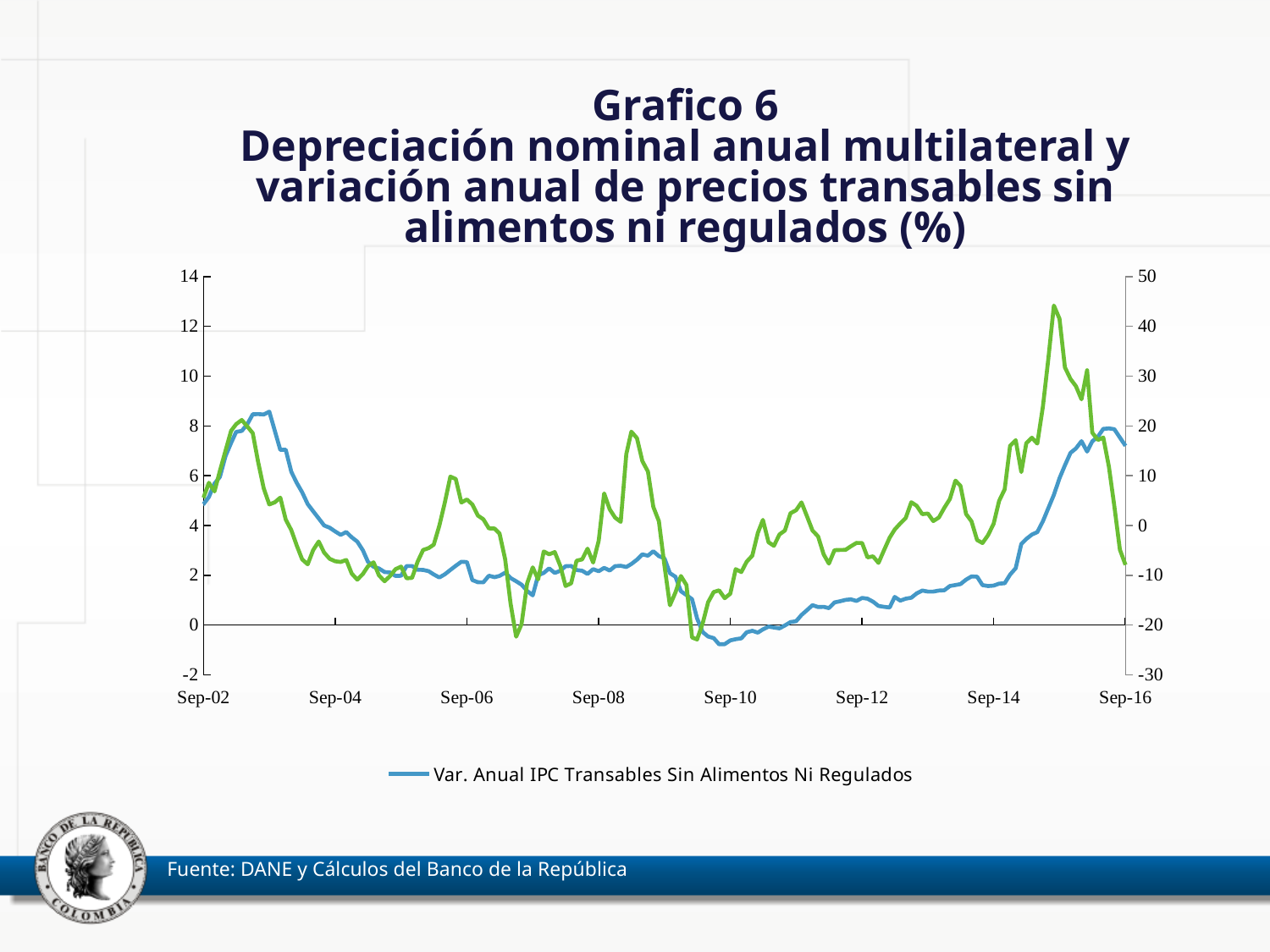
What is the number of the graph given in the title? Grafico 6 Does the blue line (Var. Anual IPC Transables) rise or fall between Sep-12 and Sep-16? rise Is the value of the blue line (Var. Anual IPC Transables) at Sep-02 greater or less than 4 on the left axis? greater How many series does the legend list? 1 Is the peak of the green line, reached between Sep-14 and Sep-16, greater or less than 40 on the right axis? greater Does the blue line (Var. Anual IPC Transables) rise or fall between Sep-04 and Sep-06? fall Is the value of the blue line (Var. Anual IPC Transables) at Sep-16 greater or less than 6 on the left axis? greater How many date labels are shown on the x axis? 8 What is the series named in the legend? Var. Anual IPC Transables Sin Alimentos Ni Regulados What kind of chart is shown on the slide? Line chart Which is larger for the blue line (Var. Anual IPC Transables): the value at Sep-02 or the value at Sep-16? Sep-16